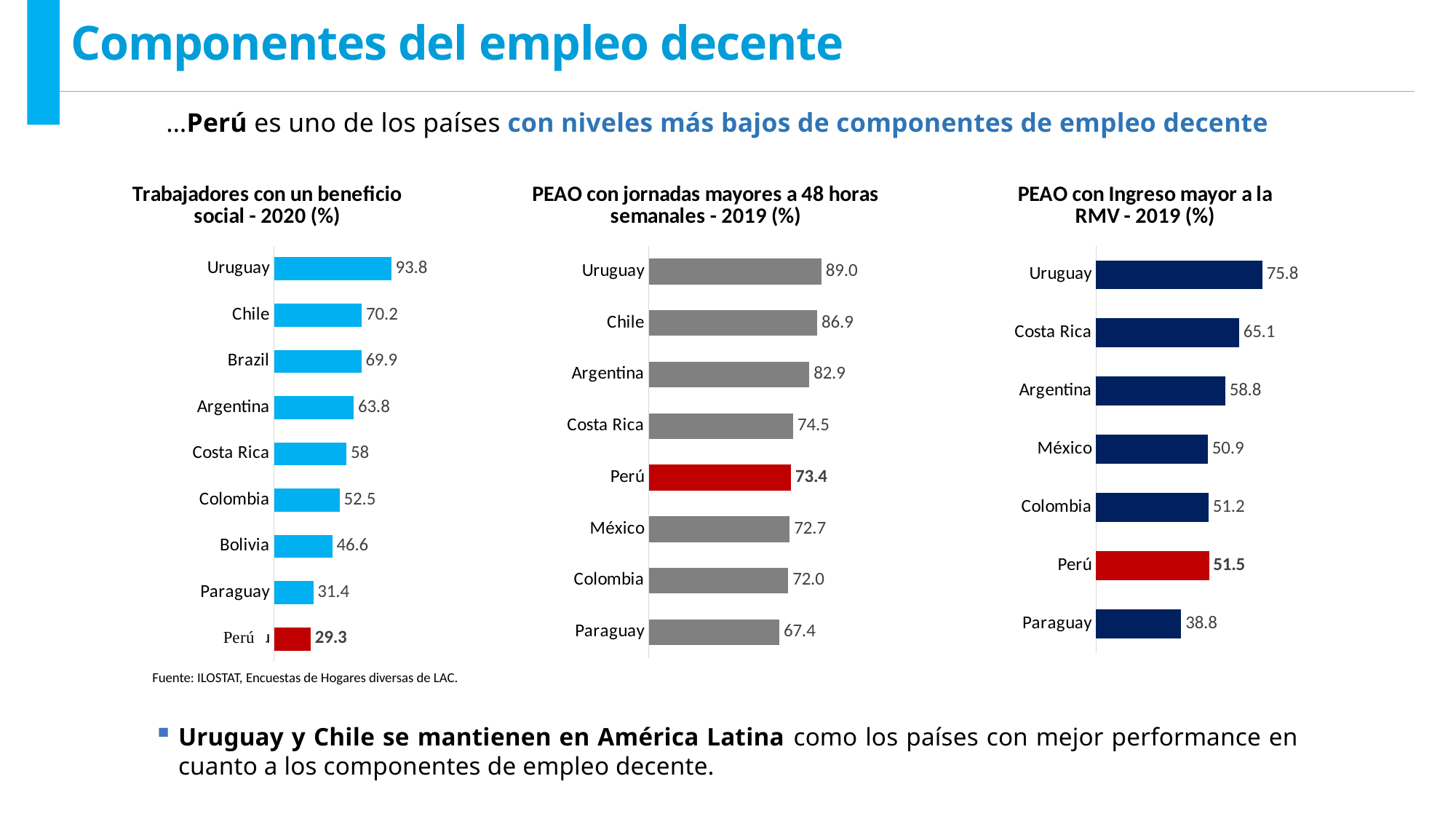
In the chart 'Trabajadores con un beneficio social - 2020 (%)', how many countries are shown? 9 In the chart 'PEAO con jornadas mayores a 48 horas semanales - 2019 (%)', which country has the highest value? Uruguay In the chart 'Trabajadores con un beneficio social - 2020 (%)', what is the value for Uruguay? 93.8 In the chart 'PEAO con Ingreso mayor a la RMV - 2019 (%)', what is the difference between Uruguay and Perú? 24.3 In the chart 'PEAO con jornadas mayores a 48 horas semanales - 2019 (%)', how many countries are shown? 8 In the chart 'Trabajadores con un beneficio social - 2020 (%)', which country has the lowest value? Perú In the chart 'PEAO con Ingreso mayor a la RMV - 2019 (%)', what is the value for Costa Rica? 65.1 What type of chart is the chart 'PEAO con Ingreso mayor a la RMV - 2019 (%)'? Bar chart In the chart 'PEAO con jornadas mayores a 48 horas semanales - 2019 (%)', which country has the lowest value? Paraguay In the chart 'PEAO con Ingreso mayor a la RMV - 2019 (%)', which is larger, Perú or Paraguay? Perú In the chart 'Trabajadores con un beneficio social - 2020 (%)', what is the difference between Chile and Brazil? 0.3 In the chart 'PEAO con jornadas mayores a 48 horas semanales - 2019 (%)', what is the value for Perú? 73.4